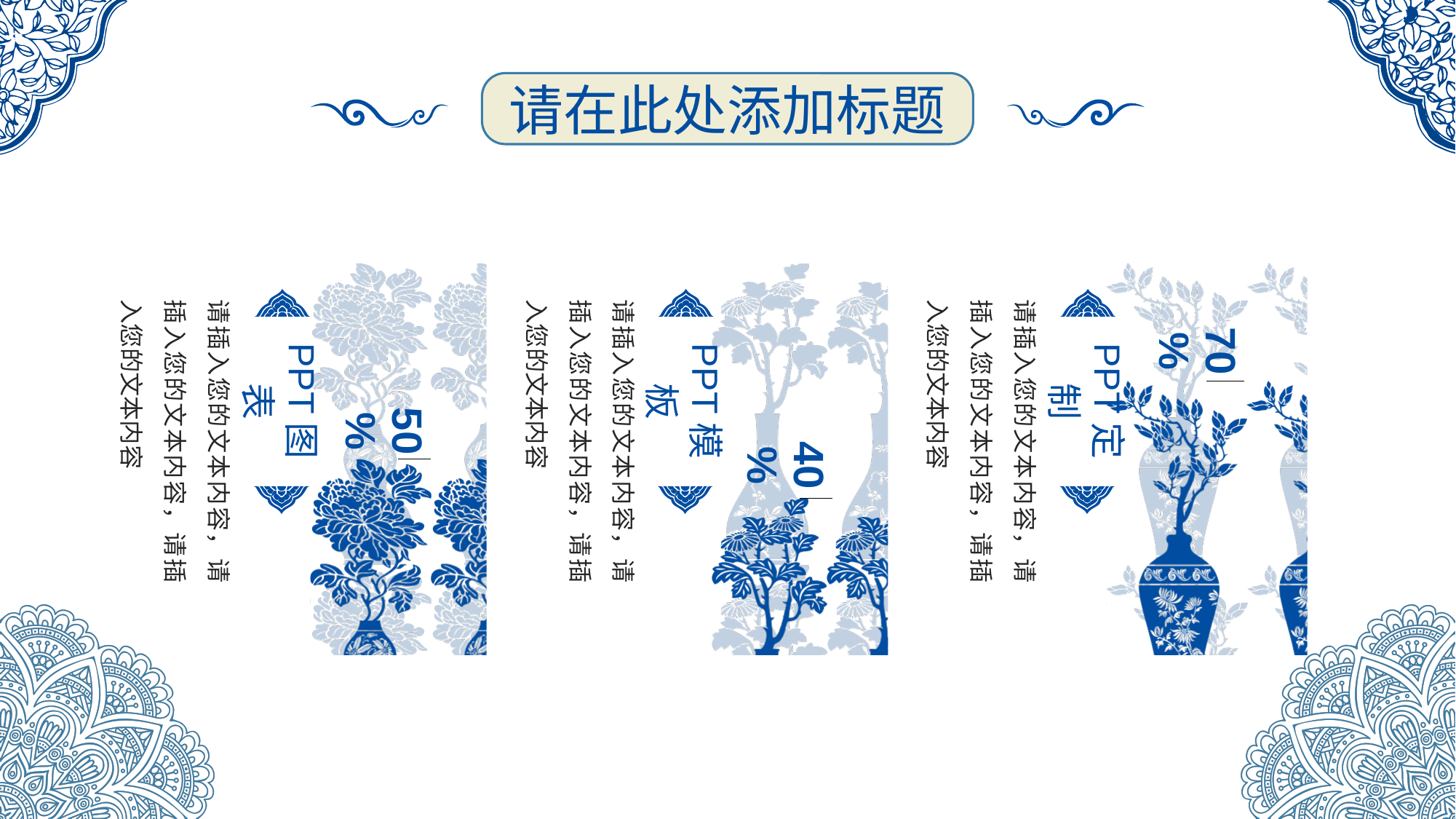
What percentage is shown for the PPT模板 panel? 40% How many percentage panels are shown on the slide? 3 Which panel shows the lowest percentage? PPT模板 What is the difference between the percentages for PPT图表 and PPT模板? 10% What colour are the percentage values printed in? Blue Which panel shows the highest percentage? PPT定制 What is the difference between the percentages for PPT定制 and PPT模板? 30% What is the title of the slide? 请在此处添加标题 Which is larger, the percentage for PPT图表 or for PPT定制? PPT定制 What percentage is shown for the PPT图表 panel? 50% What percentage is shown for the PPT定制 panel? 70%